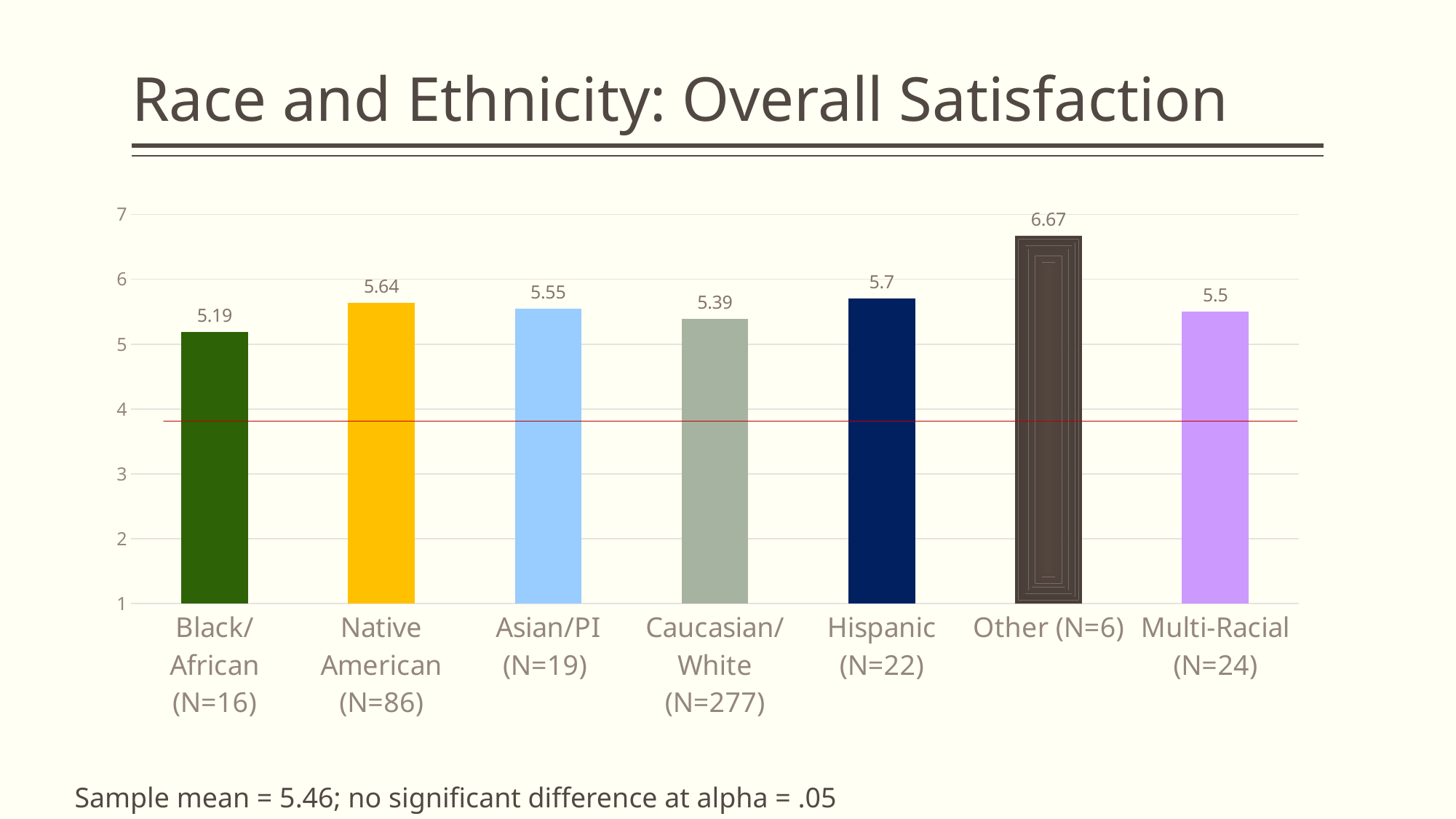
Which category has the highest overall satisfaction? Other (N=6) What is the overall satisfaction value for Native American (N=86)? 5.64 What is the title of the slide? Race and Ethnicity: Overall Satisfaction What is the difference between the values for Native American (N=86) and Asian/PI (N=19)? 0.09 Which is larger, the value for Multi-Racial (N=24) or the value for Caucasian/White (N=277)? Multi-Racial (N=24) Which category has the lowest overall satisfaction? Black/African (N=16) What is the overall satisfaction value for Hispanic (N=22)? 5.7 How many categories are shown on the x axis? 7 What is the difference between the values for Other (N=6) and Black/African (N=16)? 1.48 Is the value for Other (N=6) greater or less than 6? greater What is the overall satisfaction value for Caucasian/White (N=277)? 5.39 What kind of chart is shown on the slide? Bar chart